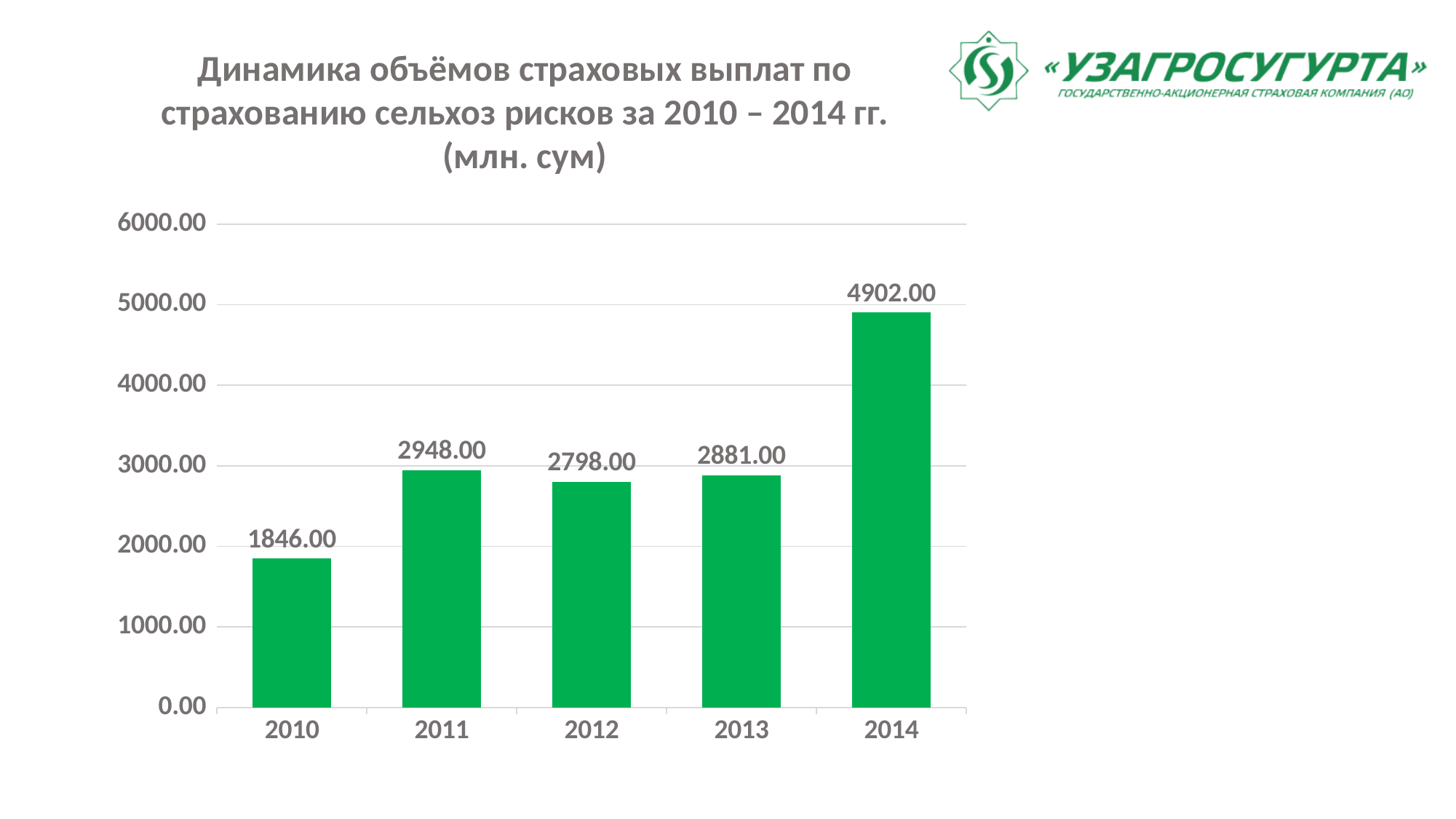
What is the value for 2014? 4902.00 What is the difference between the values for 2014 and 2013? 2021.00 How many years are shown on the x axis? 5 What kind of chart is shown on the slide? bar chart What is the difference between the values for 2011 and 2010? 1102.00 Is the value for 2013 greater or less than 3000.00? less What is the value for 2010? 1846.00 What is the value for 2012? 2798.00 What unit is given in the chart title? млн. сум Which year has the highest value? 2014 Which year has the lowest value? 2010 Which is larger, the value for 2011 or the value for 2012? 2011